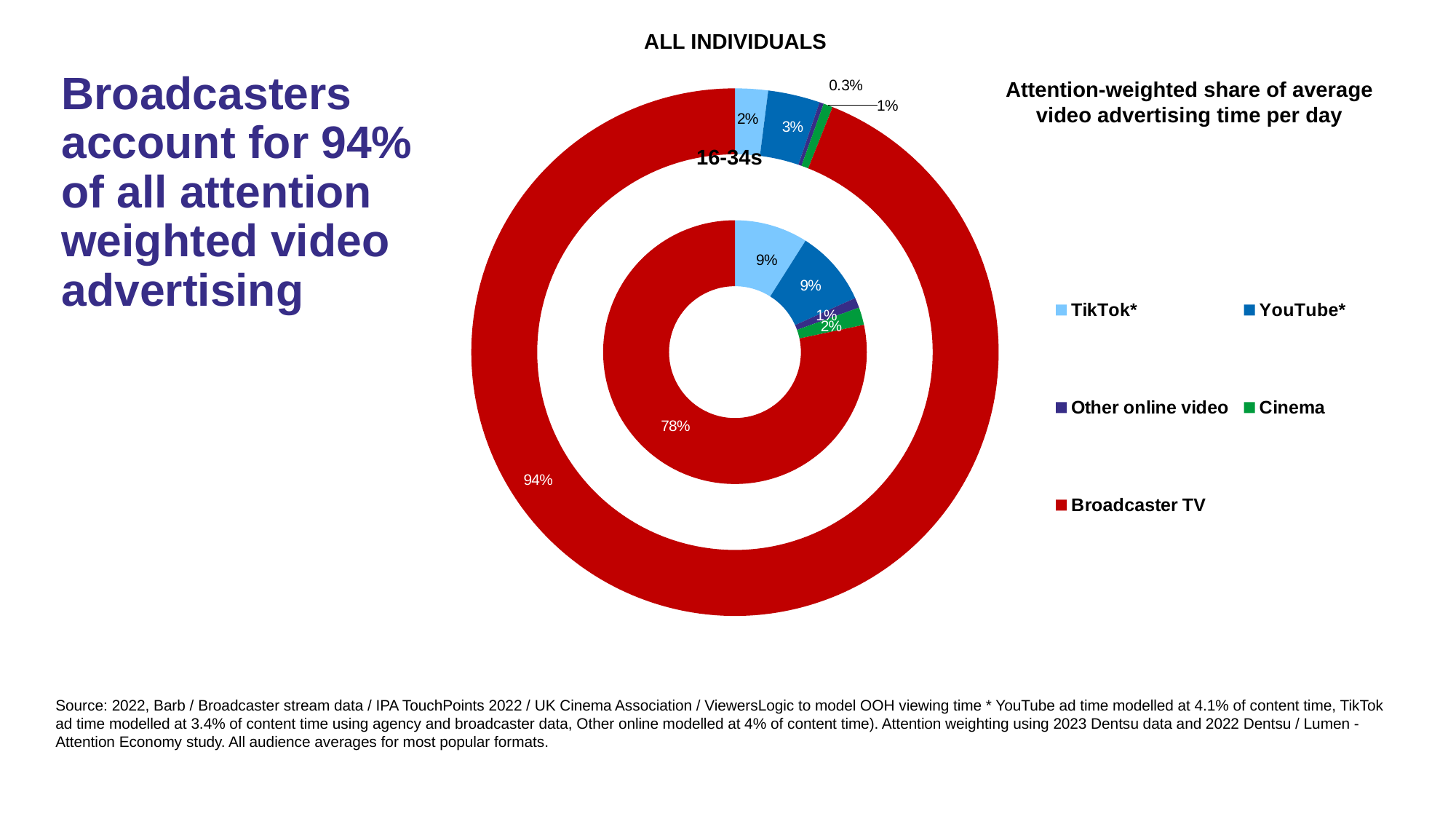
What is the share for Other online video among all individuals (outer ring)? 0.3% Which category has the smallest share in the all individuals (outer) ring? Other online video What share does Broadcaster TV account for among 16-34s (inner ring)? 78% What is the share for TikTok among 16-34s (inner ring)? 9% What share of attention-weighted video advertising time does Broadcaster TV account for among all individuals (outer ring)? 94% Which category has the largest share in the 16-34s ring? Broadcaster TV What is the share for Cinema among 16-34s (inner ring)? 2% What is the share for YouTube among all individuals (outer ring)? 3% What kind of chart is shown on the slide? Doughnut chart How many categories does the legend list? 5 How much larger is Broadcaster TV's share among all individuals than among 16-34s? 16 percentage points Is TikTok's share larger among all individuals or among 16-34s? 16-34s